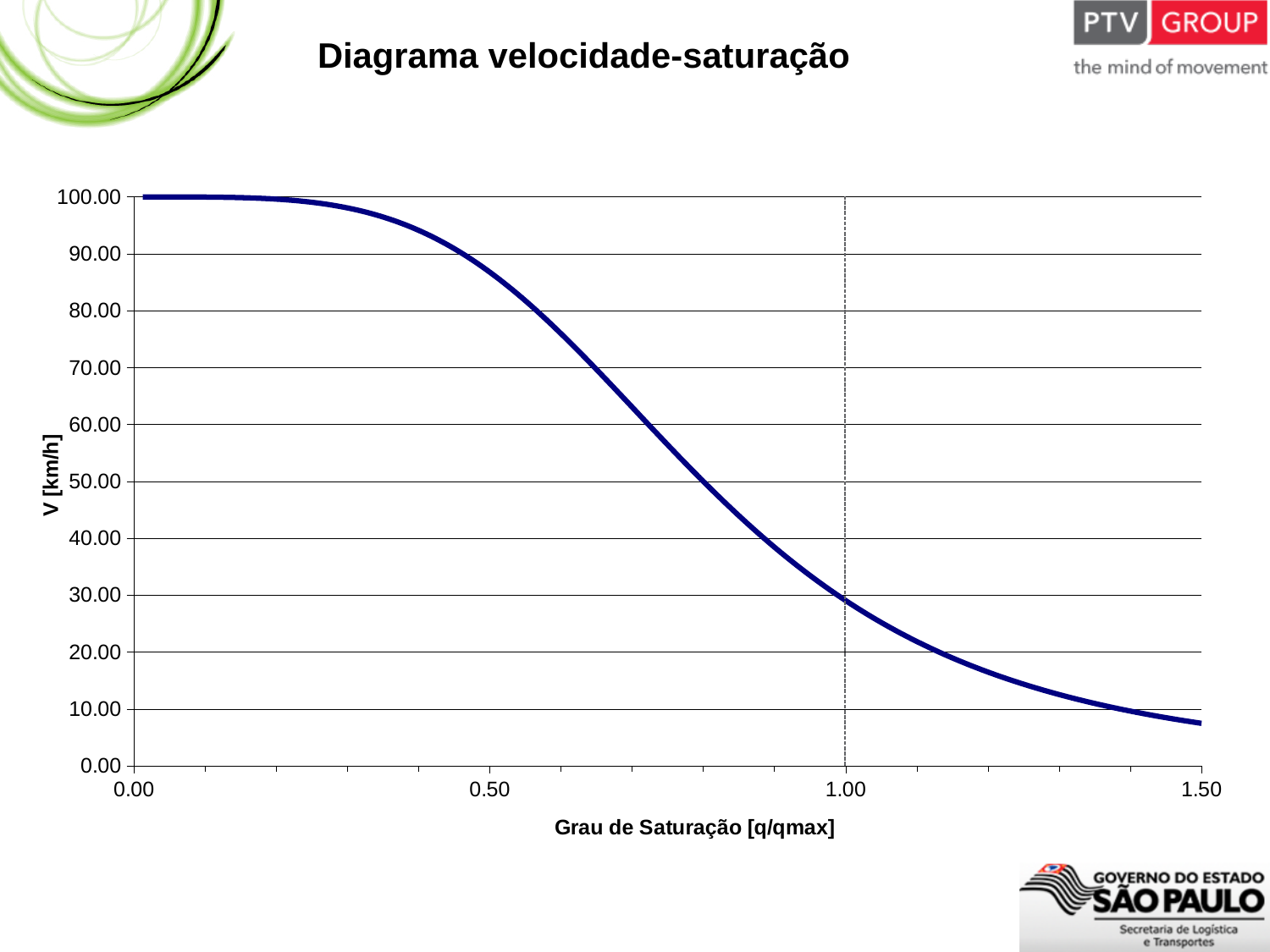
What is the title of the chart? Diagrama velocidade-saturação What kind of chart is shown on the slide? line chart Which degree of saturation has the higher value of V: 0.50 or 1.00? 0.50 Is the value of V at a degree of saturation of 1.50 greater or less than 10.00? less What is the label of the x axis? Grau de Saturação [q/qmax] Is the value of V at a degree of saturation of 0.75 greater or less than 50.00? greater Is the value of V at a degree of saturation of 0.50 greater or less than 80.00? greater What is the value of V [km/h] at a degree of saturation of 0.00? 100.00 At which degree of saturation shown on the x axis is V highest? 0.00 Does the speed V rise or fall as the degree of saturation increases along the x axis? fall